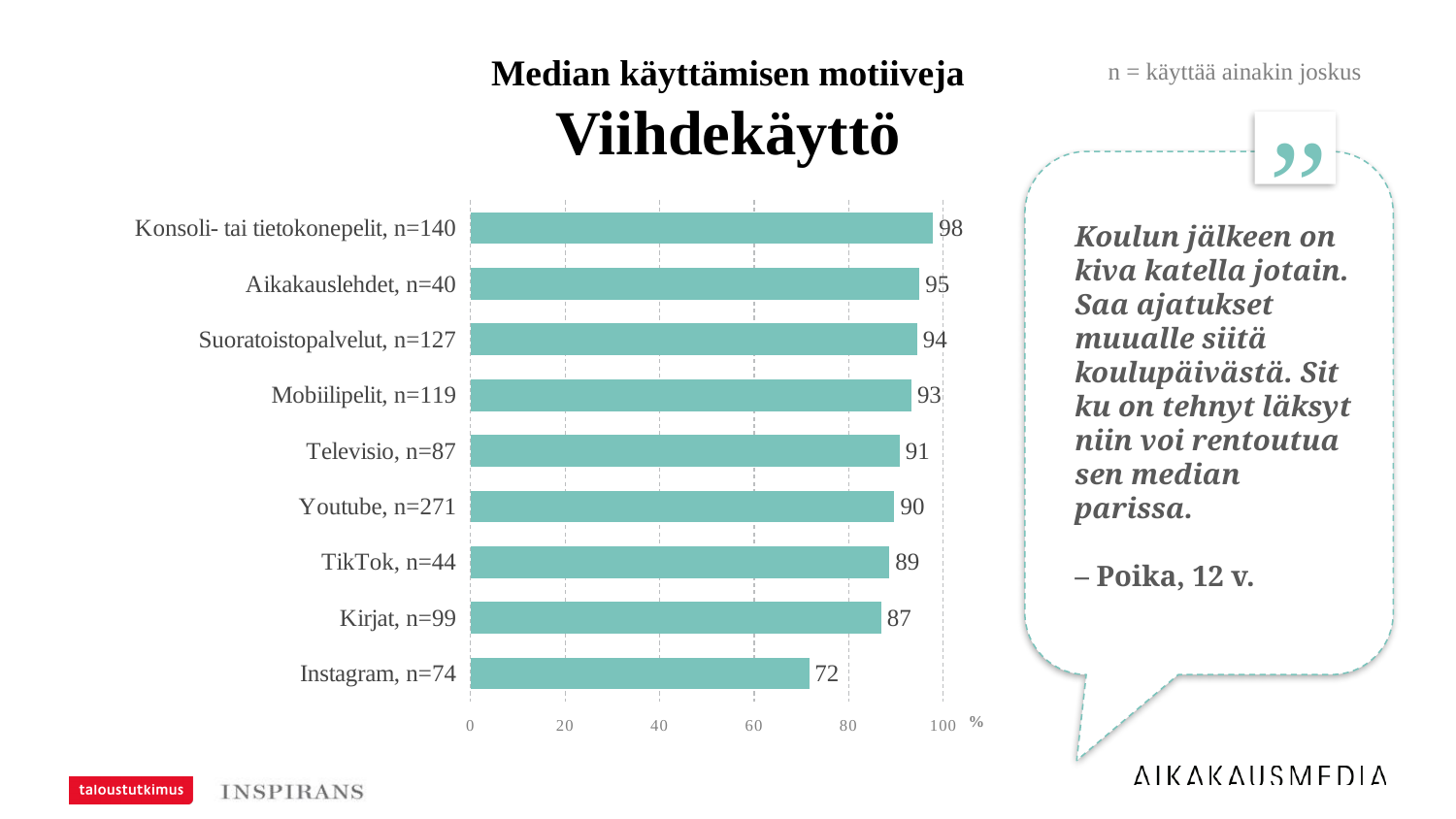
What is the value for Instagram, n=74? 72 What is the title of the chart? Median käyttämisen motiiveja Viihdekäyttö Which is larger, the value for Televisio, n=87 or the value for Kirjat, n=99? Televisio, n=87 What is the value for Kirjat, n=99? 87 What is the value for Konsoli- tai tietokonepelit, n=140? 98 What is the difference between the values for Aikakauslehdet, n=40 and TikTok, n=44? 6 Which category has the lowest value? Instagram, n=74 What is the difference between the values for Konsoli- tai tietokonepelit, n=140 and Instagram, n=74? 26 What kind of chart is shown on the slide? Bar chart Which category has the highest value? Konsoli- tai tietokonepelit, n=140 How many categories are shown in the chart? 9 What is the value for Youtube, n=271? 90